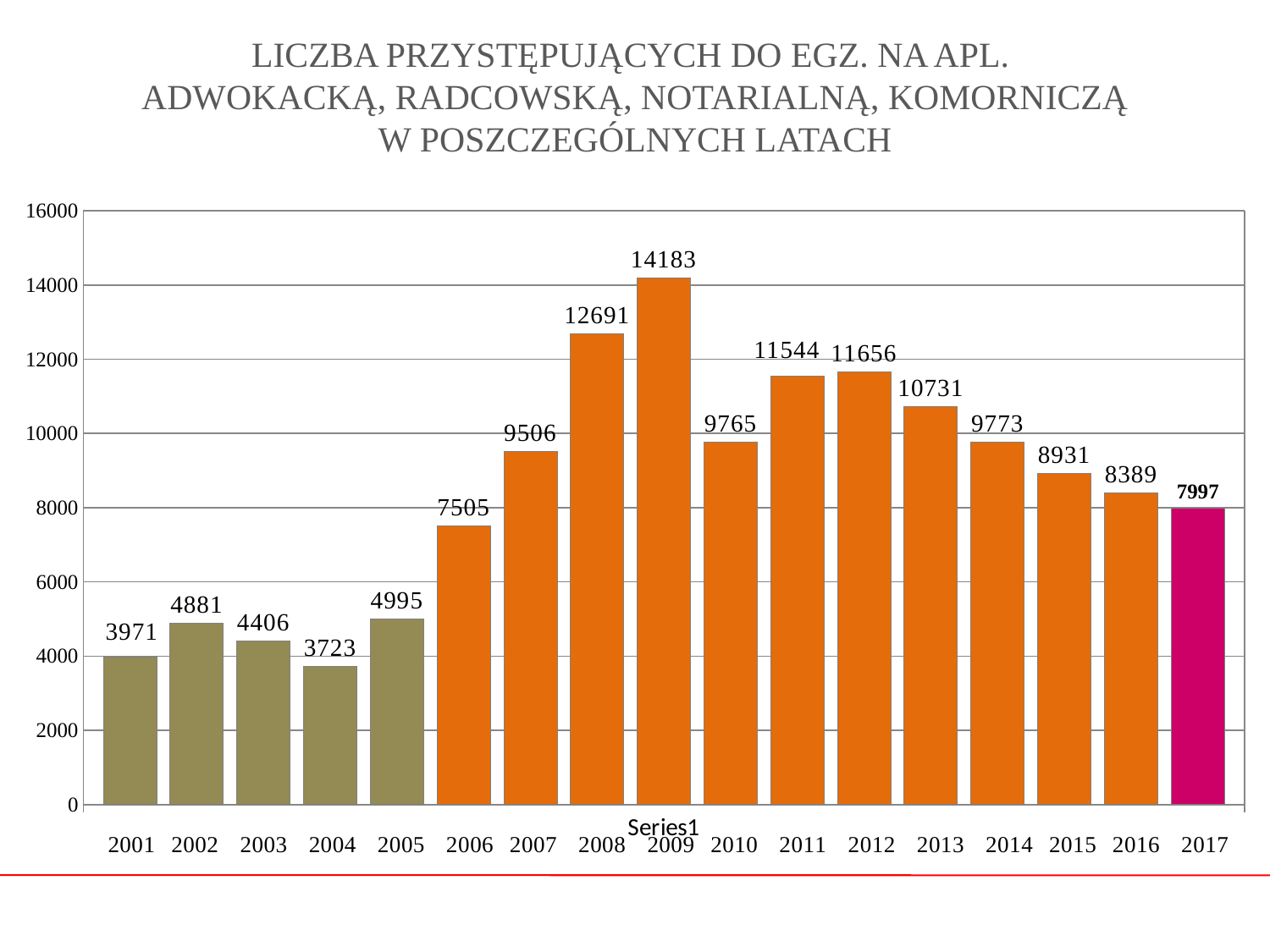
Which is larger, the value for 2011 or the value for 2012? 2012 What colour is the bar for 2017? magenta Do the values rise or fall from 2012 to 2017? fall What is the value for 2009? 14183 Which year has the highest value? 2009 What kind of chart is shown on the slide? bar chart How many years are shown on the x axis? 17 Which year has the lowest value? 2004 What is the difference between the values for 2009 and 2008? 1492 What is the value for 2004? 3723 What is the value for 2017? 7997 Is the value for 2006 greater or less than 8000? less